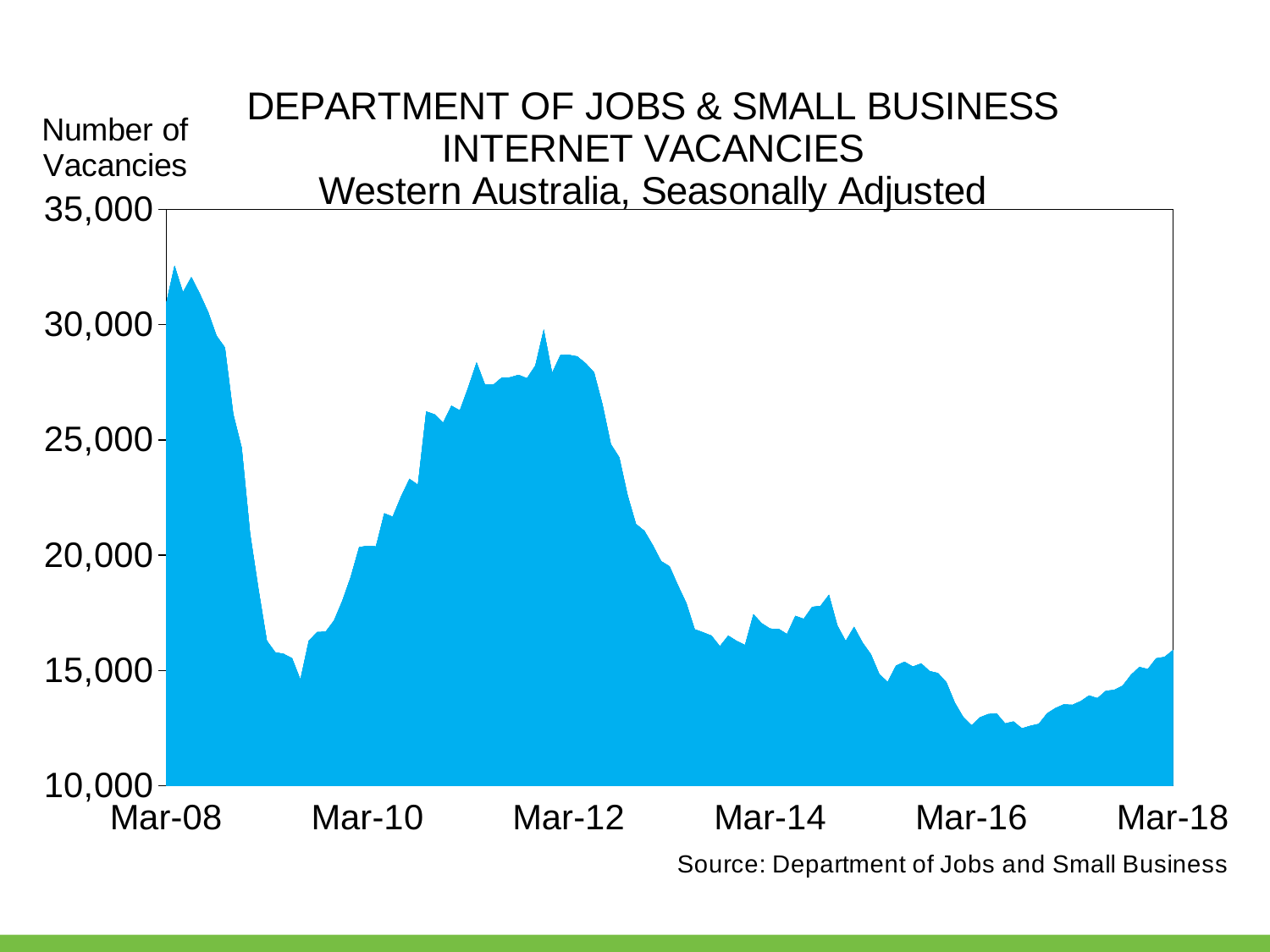
Do the number of vacancies rise or fall between Mar-12 and Mar-16? fall Do the number of vacancies rise or fall between Mar-16 and Mar-18? rise Is the number of vacancies at Mar-16 greater or less than 15,000? less Is the number of vacancies at Mar-08 greater or less than 30,000? greater Is the number of vacancies at Mar-18 greater or less than 20,000? less Which is larger, the number of vacancies at Mar-08 or at Mar-18? Mar-08 How many date labels are shown on the horizontal axis? 6 What is the label on the vertical axis of the chart? Number of Vacancies What kind of chart is shown on the slide? Area chart What is the title of the chart? DEPARTMENT OF JOBS & SMALL BUSINESS INTERNET VACANCIES Western Australia, Seasonally Adjusted